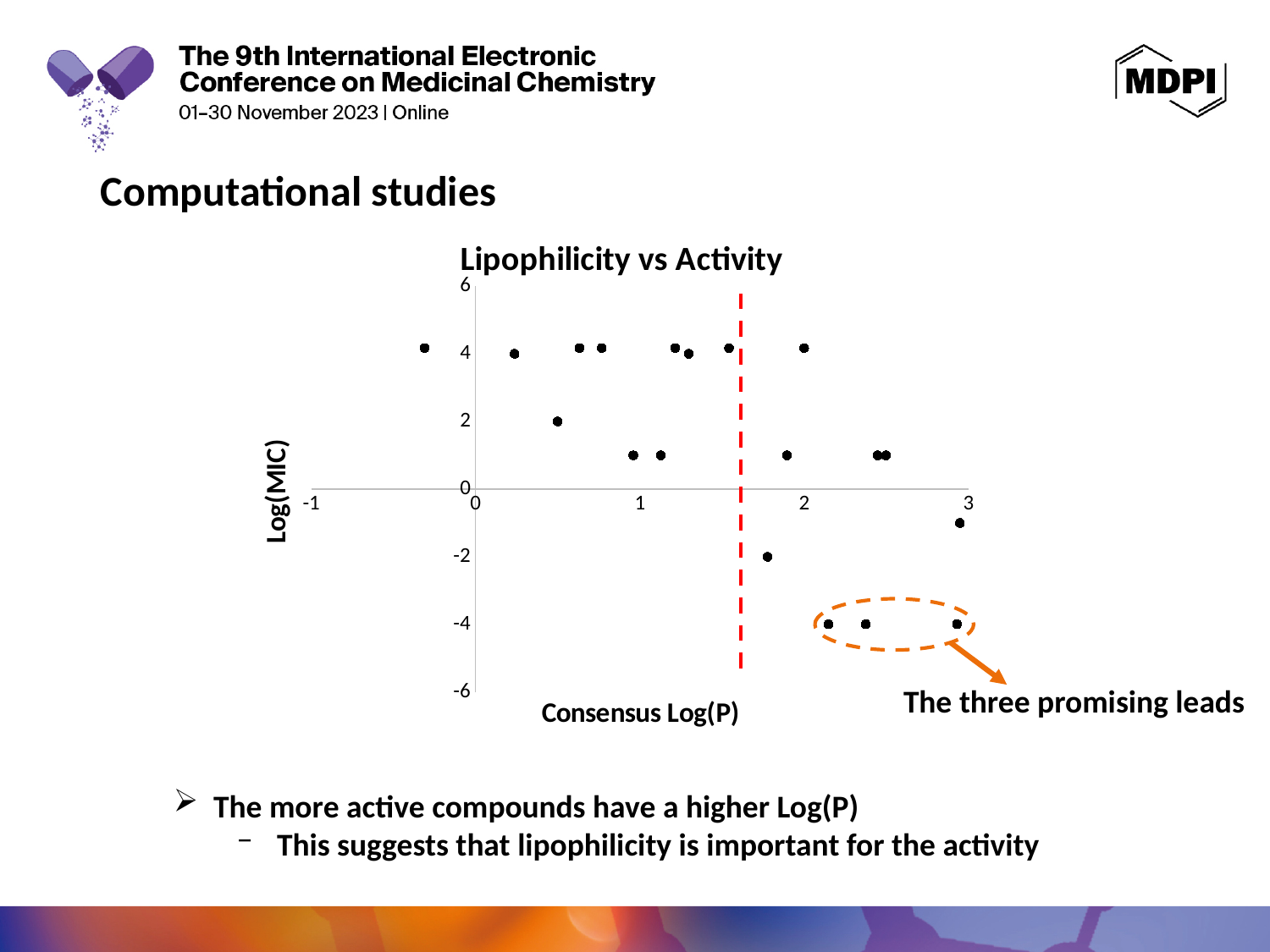
What kind of chart is shown on the slide? scatter chart Do the Log(MIC) values generally rise or fall as Consensus Log(P) increases? fall Are the Consensus Log(P) values of the three circled points greater or less than 2? greater Are the Log(MIC) values of the three circled points greater or less than -2? less Is the Log(MIC) of the point at Consensus Log(P) of about 1.75 greater or less than 0? less What is the title of the chart? Lipophilicity vs Activity Which has the higher Log(MIC): the point at Consensus Log(P) of about 0.5 or the point at Consensus Log(P) of about 1.75? the point at about 0.5 What is the label of the y axis of the chart? Log(MIC) How many data points are enclosed by the dashed orange ellipse? 3